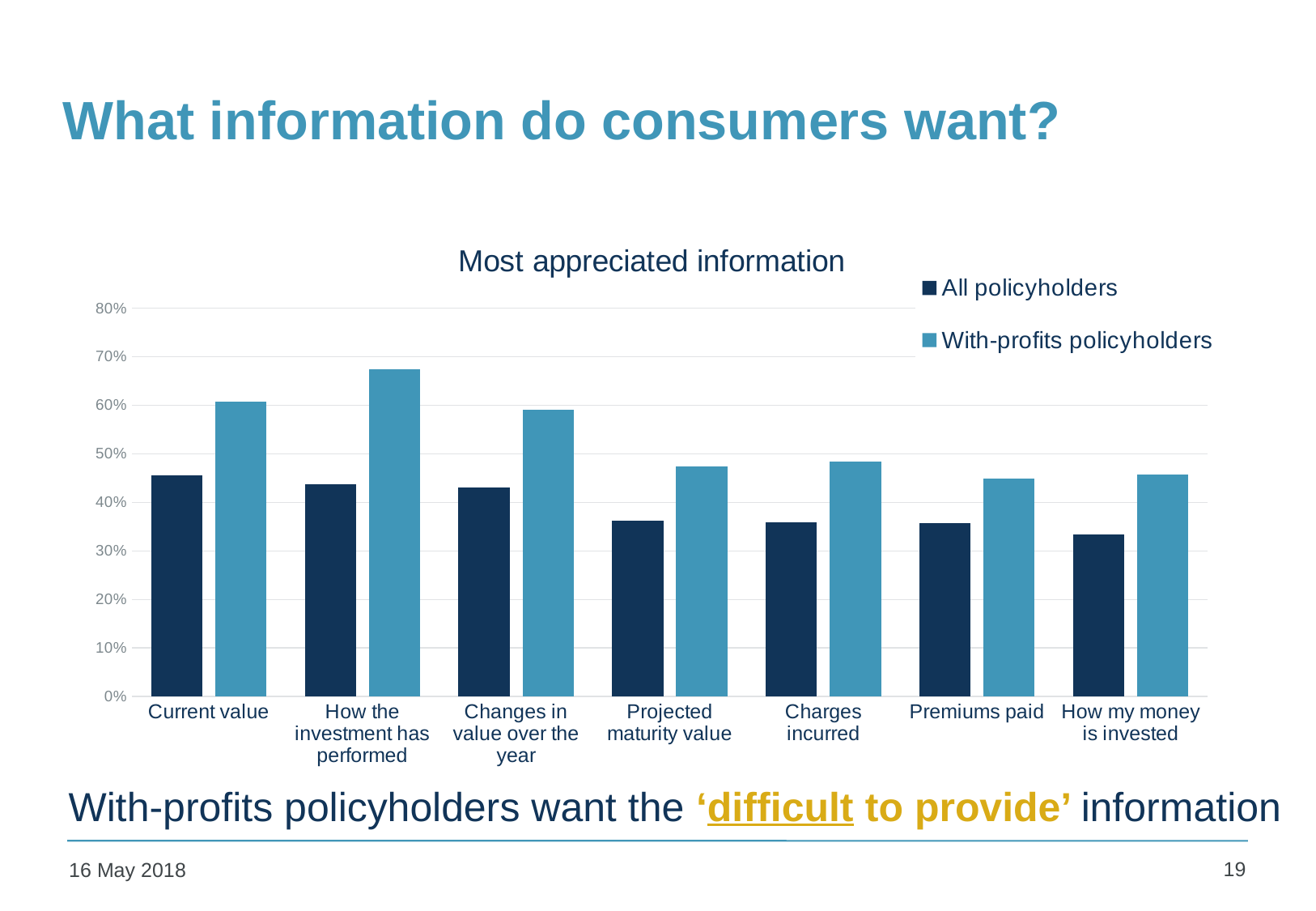
Which series is shown in the lighter blue colour? With-profits policyholders How many categories are shown on the x axis? 7 Is the value for All policyholders for 'Projected maturity value' greater or less than 40%? less Which category has the highest value for With-profits policyholders? How the investment has performed Is the value for All policyholders for 'Current value' greater or less than 50%? less What is the title of the chart? Most appreciated information How many series does the legend list? 2 Is the value for With-profits policyholders for 'Premiums paid' greater or less than 40%? greater What kind of chart is shown on the slide? Bar chart Which category has the lowest value for All policyholders? How my money is invested For 'Current value', which series has the larger value: All policyholders or With-profits policyholders? With-profits policyholders